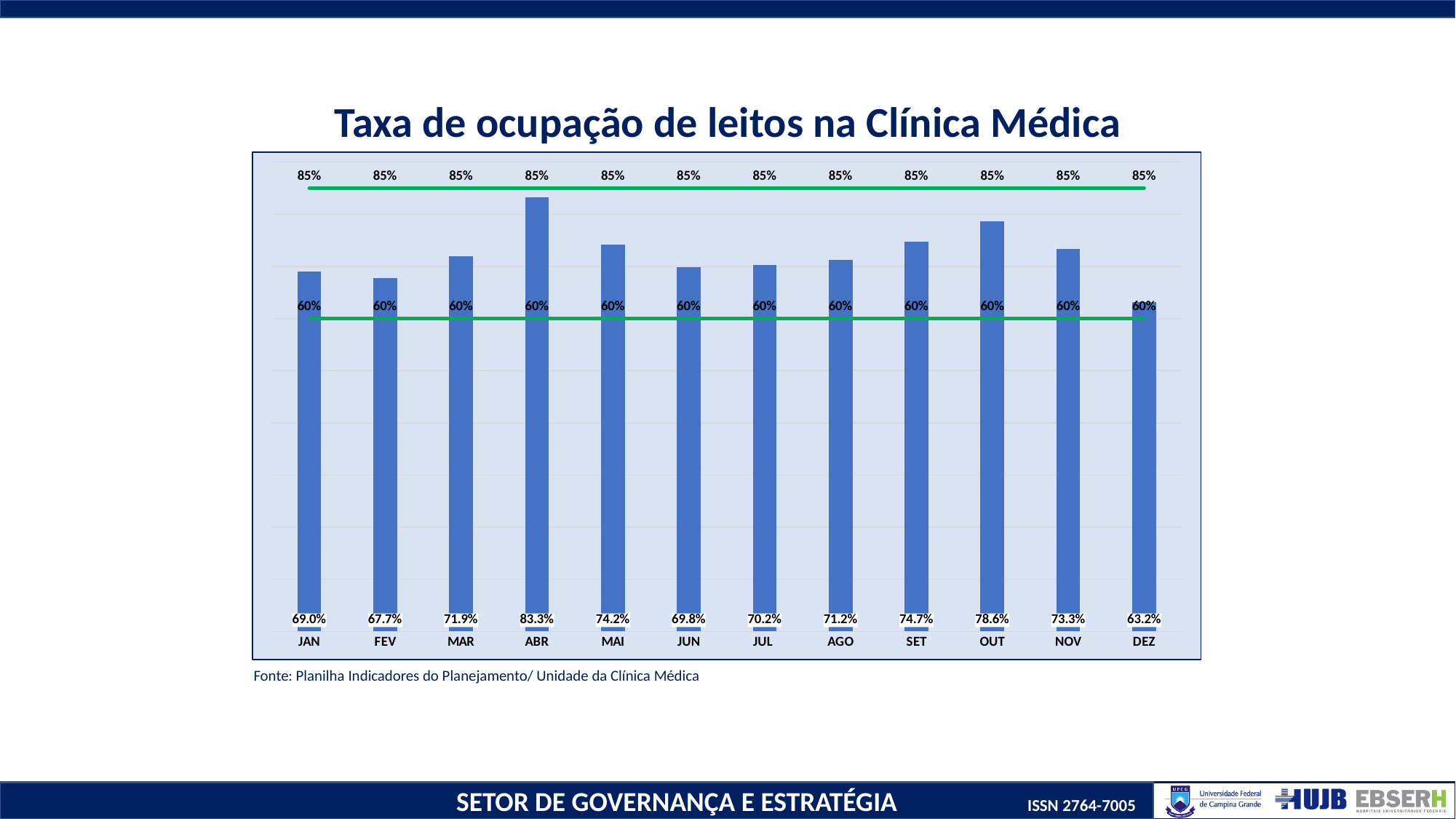
Which month has the lowest bed occupancy rate? DEZ What is the bed occupancy rate for ABR? 83.3% What kind of chart is this? bar chart What is the value of the upper green target line? 85% How many months are shown on the x axis? 12 What is the bed occupancy rate for DEZ? 63.2% Does the occupancy rate rise or fall from SET to DEZ? fall What is the bed occupancy rate for OUT? 78.6% What is the difference between the occupancy rate in ABR and in DEZ? 20.1% What is the value of the lower green target line? 60% Which month has the highest bed occupancy rate? ABR Which month has a higher occupancy rate, SET or NOV? SET